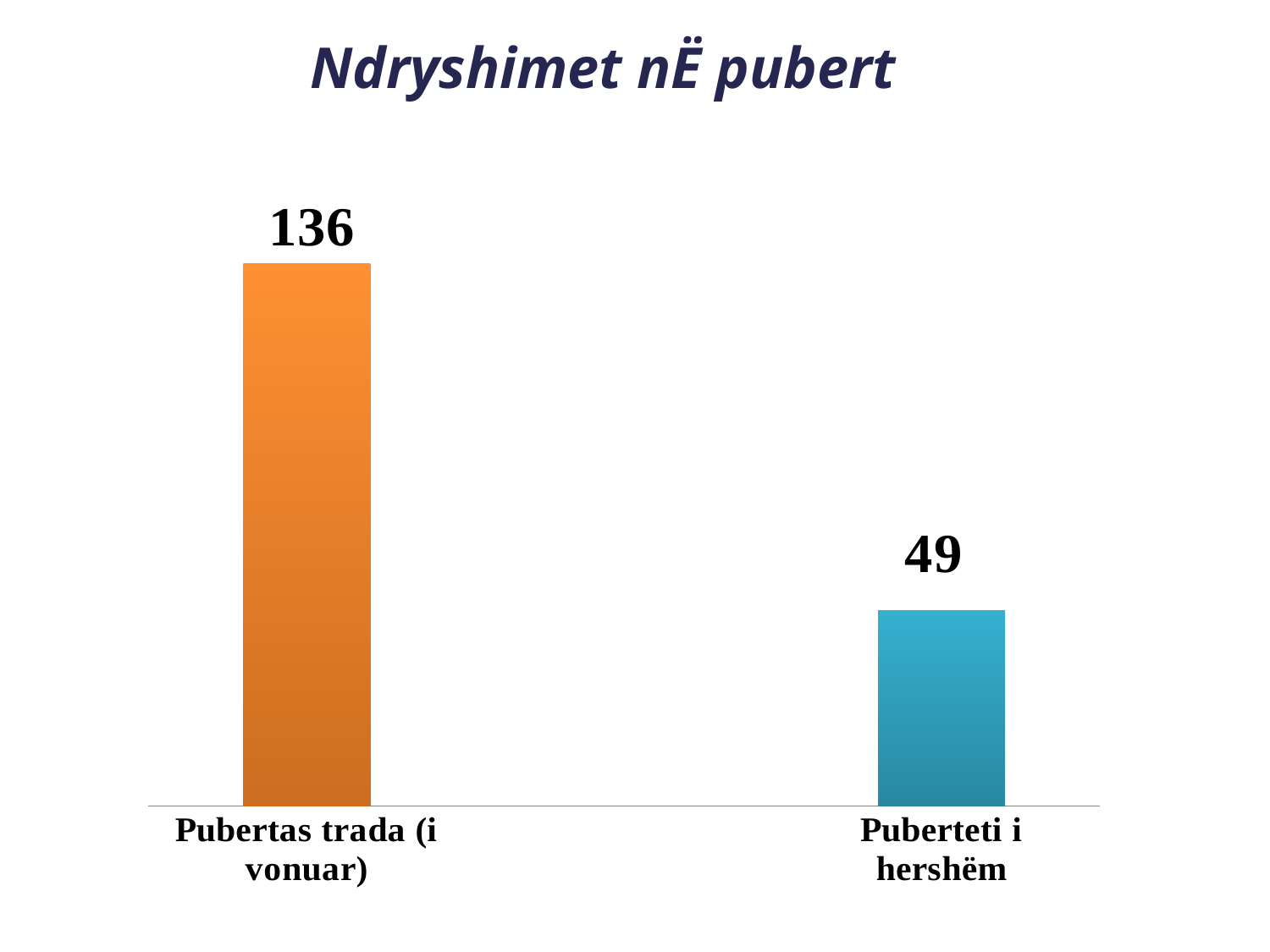
What is the value for Pubertas trada (i vonuar)? 136 What is the difference between the values for Pubertas trada (i vonuar) and Puberteti i hershëm? 87 What is the title of the slide? Ndryshimet nË pubert Which category has the lowest value? Puberteti i hershëm What is the value for Puberteti i hershëm? 49 What is the total of the two values shown in the chart? 185 What colour is the bar for Puberteti i hershëm? Blue What kind of chart is shown on the slide? Bar chart How many categories are shown in the chart? 2 Which is larger, the value for Pubertas trada (i vonuar) or the value for Puberteti i hershëm? Pubertas trada (i vonuar) Which category has the highest value? Pubertas trada (i vonuar)